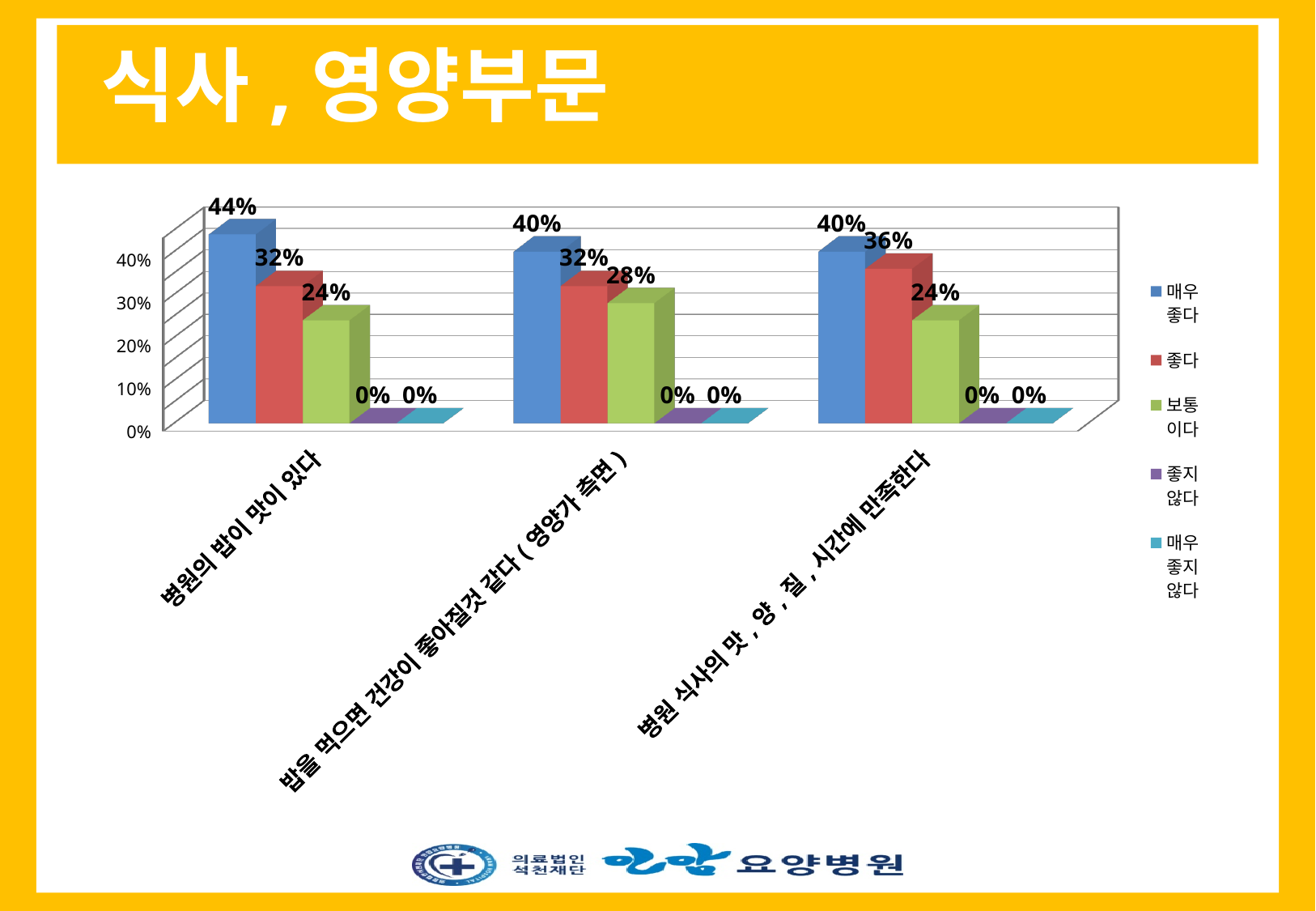
What is the value of 매우 좋다 for 병원의 밥이 맛이 있다? 44% How many categories are shown on the x axis? 3 What is the title of the slide? 식사 , 영양부문 How many series does the legend list? 5 What is the value of 좋다 for 병원 식사의 맛, 양, 질, 시간에 만족한다? 36% What is the difference between the 매우 좋다 and 좋다 values for 병원의 밥이 맛이 있다? 12% Which category has the highest 매우 좋다 value? 병원의 밥이 맛이 있다 Which category has the highest 좋다 value? 병원 식사의 맛, 양, 질, 시간에 만족한다 What is the value of 보통이다 for 밥을 먹으면 건강이 좋아질것 같다 (영양가 측면)? 28% What kind of chart is shown on the slide? bar chart Which is larger for 밥을 먹으면 건강이 좋아질것 같다 (영양가 측면): 좋다 or 보통이다? 좋다 What is the value of 매우 좋지 않다 for 병원 식사의 맛, 양, 질, 시간에 만족한다? 0%